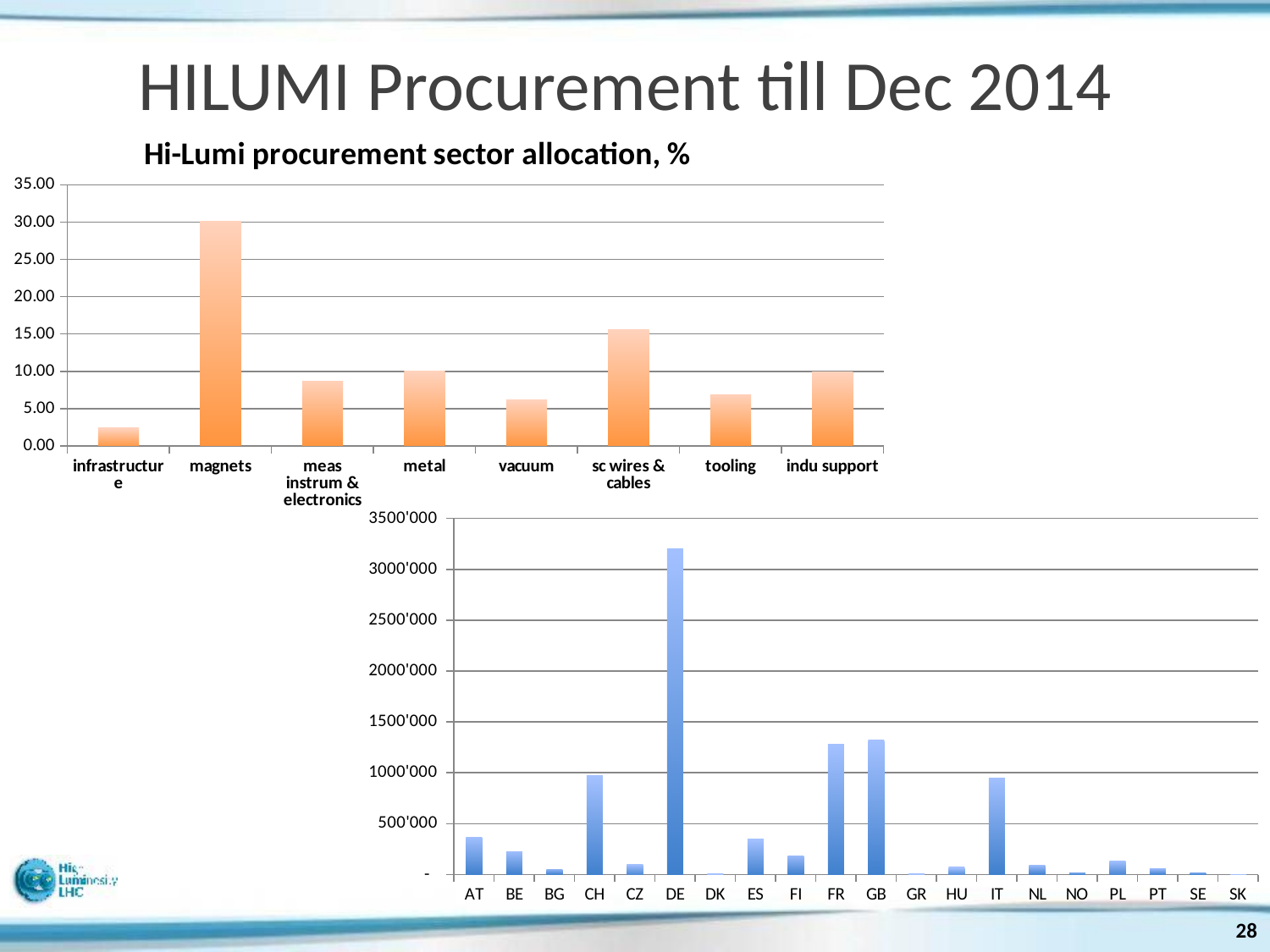
In the 'Hi-Lumi procurement sector allocation, %' chart, which sector has the lowest value? infrastructure In the 'Hi-Lumi procurement sector allocation, %' chart, which is larger: the value for metal or the value for vacuum? metal How many sectors are shown in the 'Hi-Lumi procurement sector allocation, %' chart? 8 In the 'Hi-Lumi procurement sector allocation, %' chart, which sector has the highest value? magnets In the 'Hi-Lumi procurement sector allocation, %' chart, is the value for sc wires & cables greater or less than 20.00? less In the bottom chart with country codes, is the value for DE greater or less than 3000'000? greater How many countries are shown on the x axis of the bottom chart? 20 In the bottom chart with country codes, which country has the highest value? DE In the bottom chart with country codes, which is larger: the value for FR or the value for IT? FR In the 'Hi-Lumi procurement sector allocation, %' chart, is the value for magnets greater or less than 25.00? greater What kind of chart is the 'Hi-Lumi procurement sector allocation, %' chart? bar chart